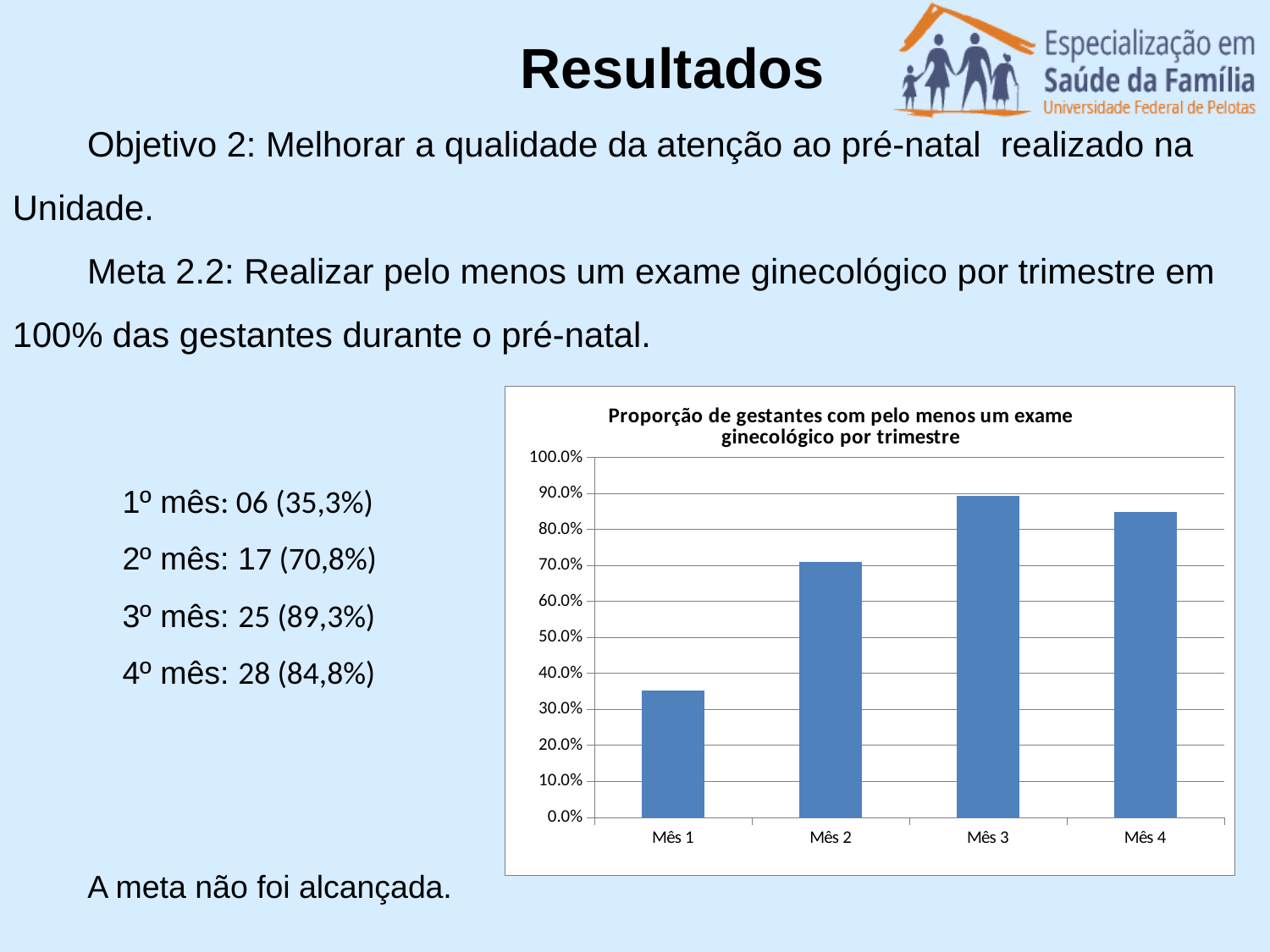
What type of chart is shown on the slide? bar chart Is the value for Mês 4 greater or less than 80.0%? greater Is the value for Mês 3 greater or less than 90.0%? less What is the title of the chart? Proporção de gestantes com pelo menos um exame ginecológico por trimestre Which is larger, the value for Mês 3 or the value for Mês 4? Mês 3 Is the value for Mês 1 greater or less than 40.0%? less Do the values rise or fall from Mês 1 to Mês 3? rise Which month has the lowest bar in the chart? Mês 1 According to the slide text, what proportion of pregnant women had at least one gynecological exam per trimester in the 3º mês? 89,3% How many categories (months) are plotted on the chart? 4 Which month has the highest bar in the chart? Mês 3